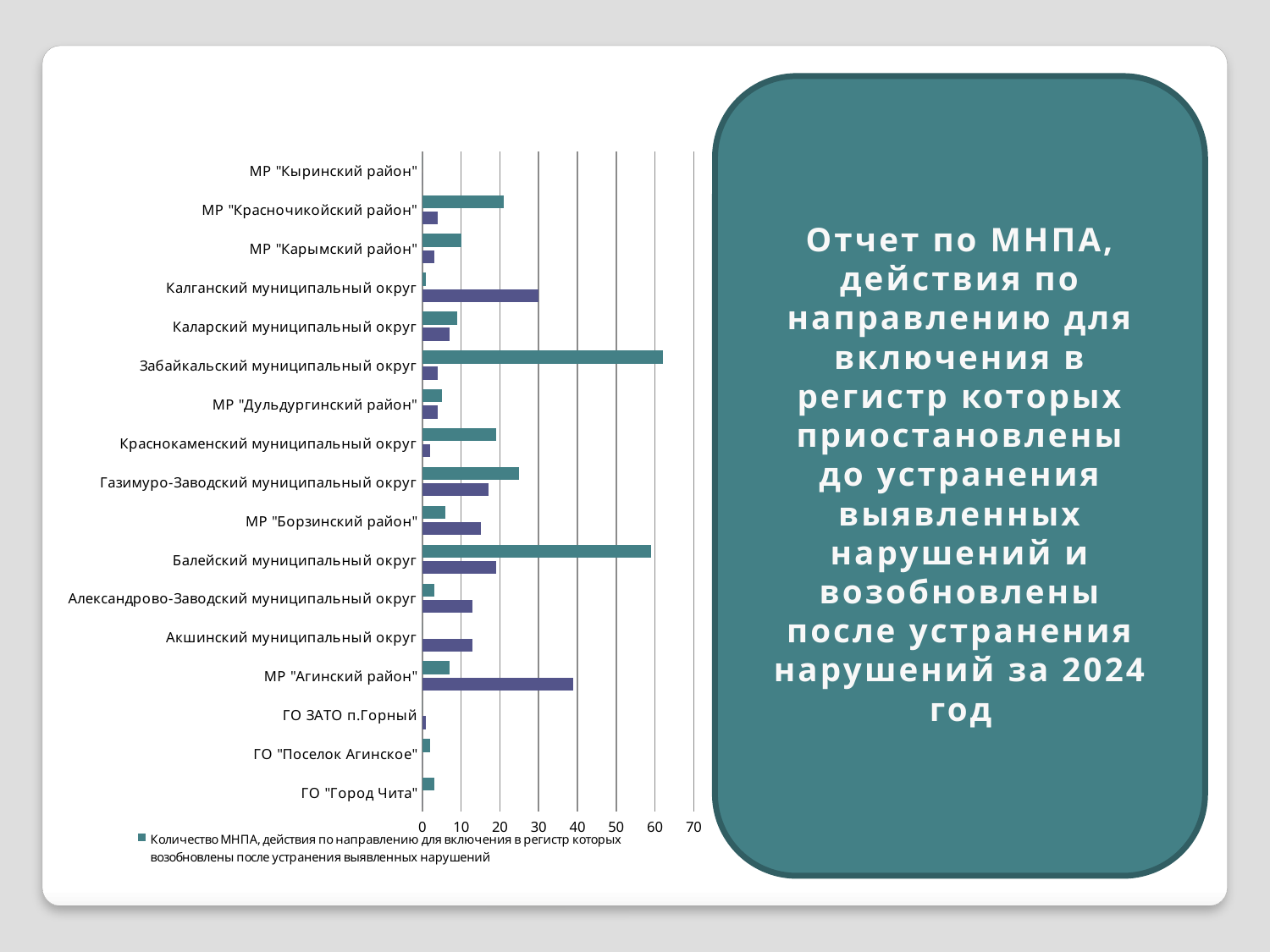
What kind of chart is shown on the slide? bar chart Is the teal bar value for Газимуро-Заводский муниципальный округ greater or less than 20? greater Which municipality has the longest purple bar? МР "Агинский район" For Балейский муниципальный округ, which bar is longer, the teal one or the purple one? teal Is the purple bar value for МР "Агинский район" greater or less than 30? greater For МР "Агинский район", which bar is longer, the teal one or the purple one? purple Which municipality has the longest teal bar (МНПА resumed after elimination of violations)? Забайкальский муниципальный округ Is the purple bar value for Калганский муниципальный округ greater or less than 40? less How many municipalities (categories) are listed on the vertical axis of the chart? 17 What is the highest value shown on the horizontal axis of the chart? 70